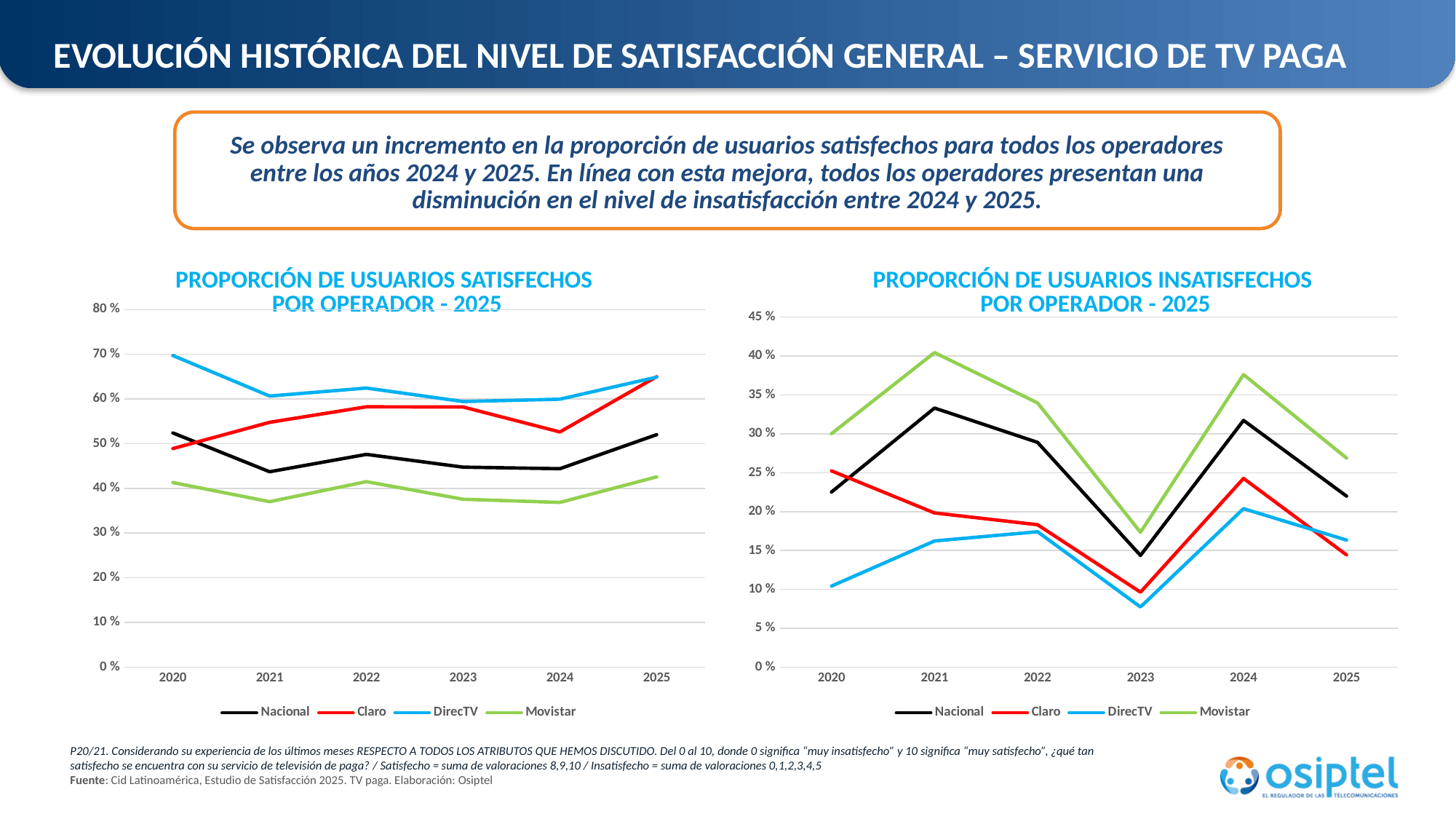
How many years are plotted along the x axis of the left chart, 'Proporción de usuarios satisfechos por operador - 2025'? 6 In the right chart, 'Proporción de usuarios insatisfechos por operador - 2025', is the value for Movistar in 2021 greater or less than 35%? greater In the right chart, 'Proporción de usuarios insatisfechos por operador - 2025', which is larger in 2022: Movistar or Claro? Movistar In the right chart, 'Proporción de usuarios insatisfechos por operador - 2025', which series has the lowest value in 2023? DirecTV How many series does the legend of the right chart, 'Proporción de usuarios insatisfechos por operador - 2025', list? 4 What kind of chart is the left chart, 'Proporción de usuarios satisfechos por operador - 2025'? line chart In the left chart, 'Proporción de usuarios satisfechos por operador - 2025', which operator has the lowest value in 2020? Movistar In the left chart, 'Proporción de usuarios satisfechos por operador - 2025', is the value for Nacional in 2021 greater or less than 50%? less In the left chart, 'Proporción de usuarios satisfechos por operador - 2025', is the value for Movistar in 2025 greater or less than 50%? less In the right chart, 'Proporción de usuarios insatisfechos por operador - 2025', does the Nacional line rise or fall from 2024 to 2025? fall In the left chart, 'Proporción de usuarios satisfechos por operador - 2025', which series has the highest value in 2020? DirecTV In the right chart, 'Proporción de usuarios insatisfechos por operador - 2025', which operator has the highest value in 2021? Movistar